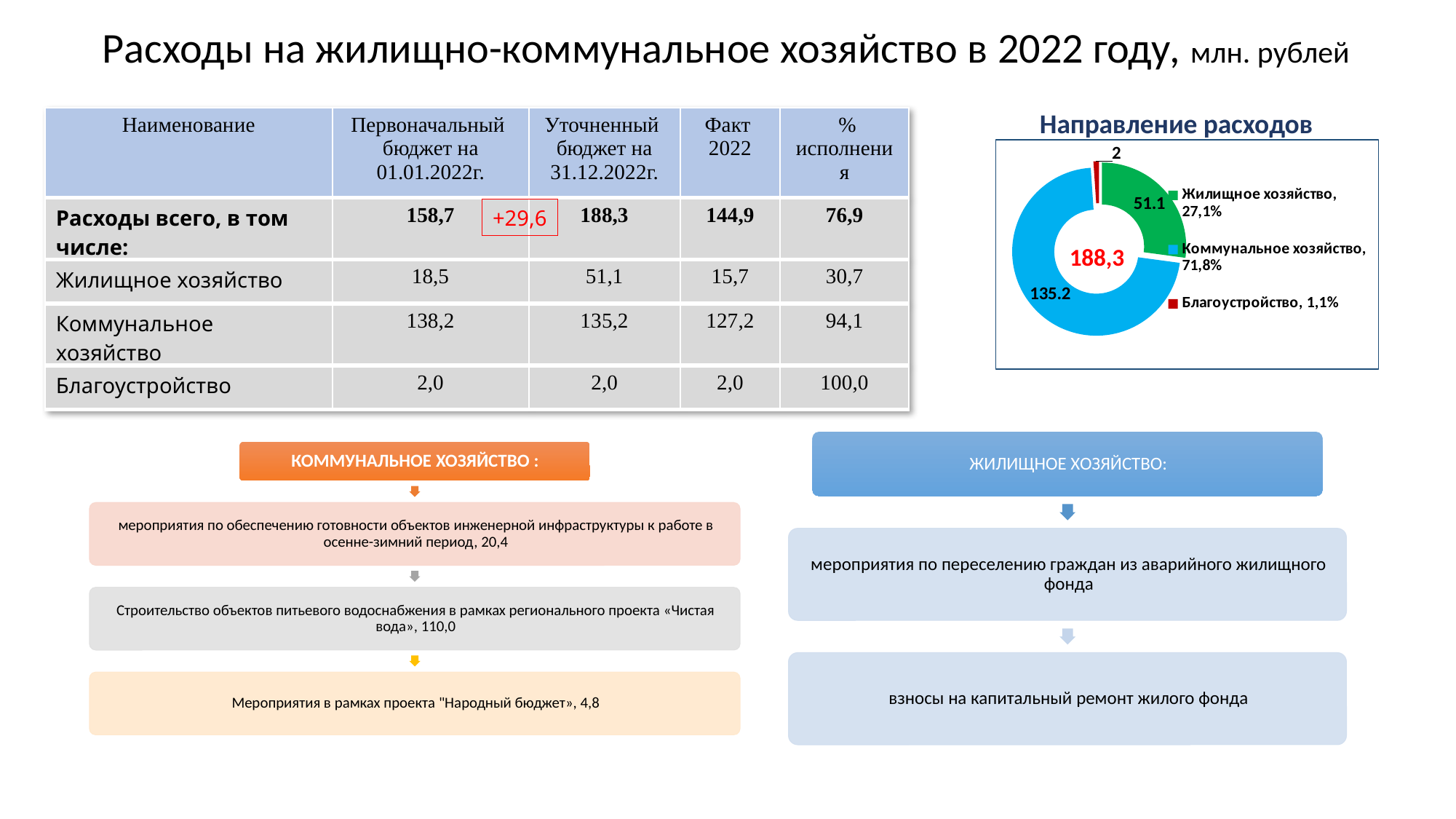
How many categories are shown in the "Направление расходов" chart? 3 In the "Направление расходов" chart, what is the difference between the values for Коммунальное хозяйство and Жилищное хозяйство? 84.1 In the "Направление расходов" chart, what value is shown for Благоустройство? 2 What kind of chart is shown under the title "Направление расходов"? doughnut chart Which category has the smallest slice in the "Направление расходов" chart? Благоустройство In the "Направление расходов" chart, what value is shown for Жилищное хозяйство? 51.1 In the "Направление расходов" chart, what share does Коммунальное хозяйство have? 71,8% In the "Направление расходов" chart, what share does Благоустройство have? 1,1% Which category has the largest slice in the "Направление расходов" chart? Коммунальное хозяйство What number is printed in the centre of the "Направление расходов" doughnut chart? 188,3 In the "Направление расходов" chart, what share does Жилищное хозяйство have? 27,1% In the "Направление расходов" chart, what value is shown for Коммунальное хозяйство? 135.2